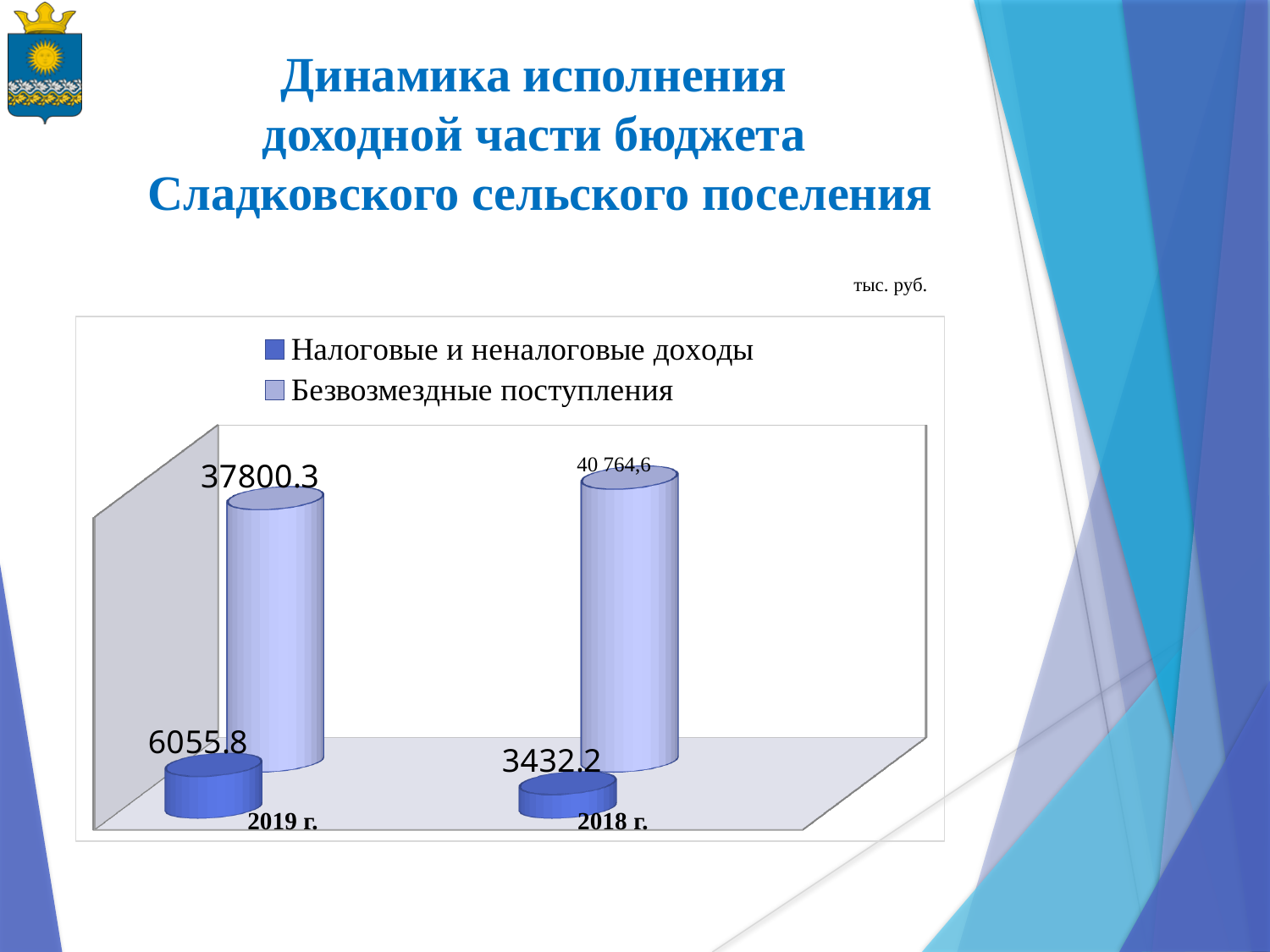
What is the value for Налоговые и неналоговые доходы in 2018 г.? 3432.2 What is the value for Налоговые и неналоговые доходы in 2019 г.? 6055.8 How many series does the legend list? 2 What is the difference between the Налоговые и неналоговые доходы values for 2019 г. and 2018 г.? 2623.6 What is the value for Безвозмездные поступления in 2018 г.? 40 764,6 What unit of measurement is indicated above the chart? тыс. руб. In which year is the value for Безвозмездные поступления lower? 2019 г. In which year is the value for Налоговые и неналоговые доходы higher? 2019 г. How many years (categories) are shown on the chart? 2 Which is larger in 2019 г.: Налоговые и неналоговые доходы or Безвозмездные поступления? Безвозмездные поступления What is the value for Безвозмездные поступления in 2019 г.? 37800.3 What kind of chart is shown on the slide? Bar chart